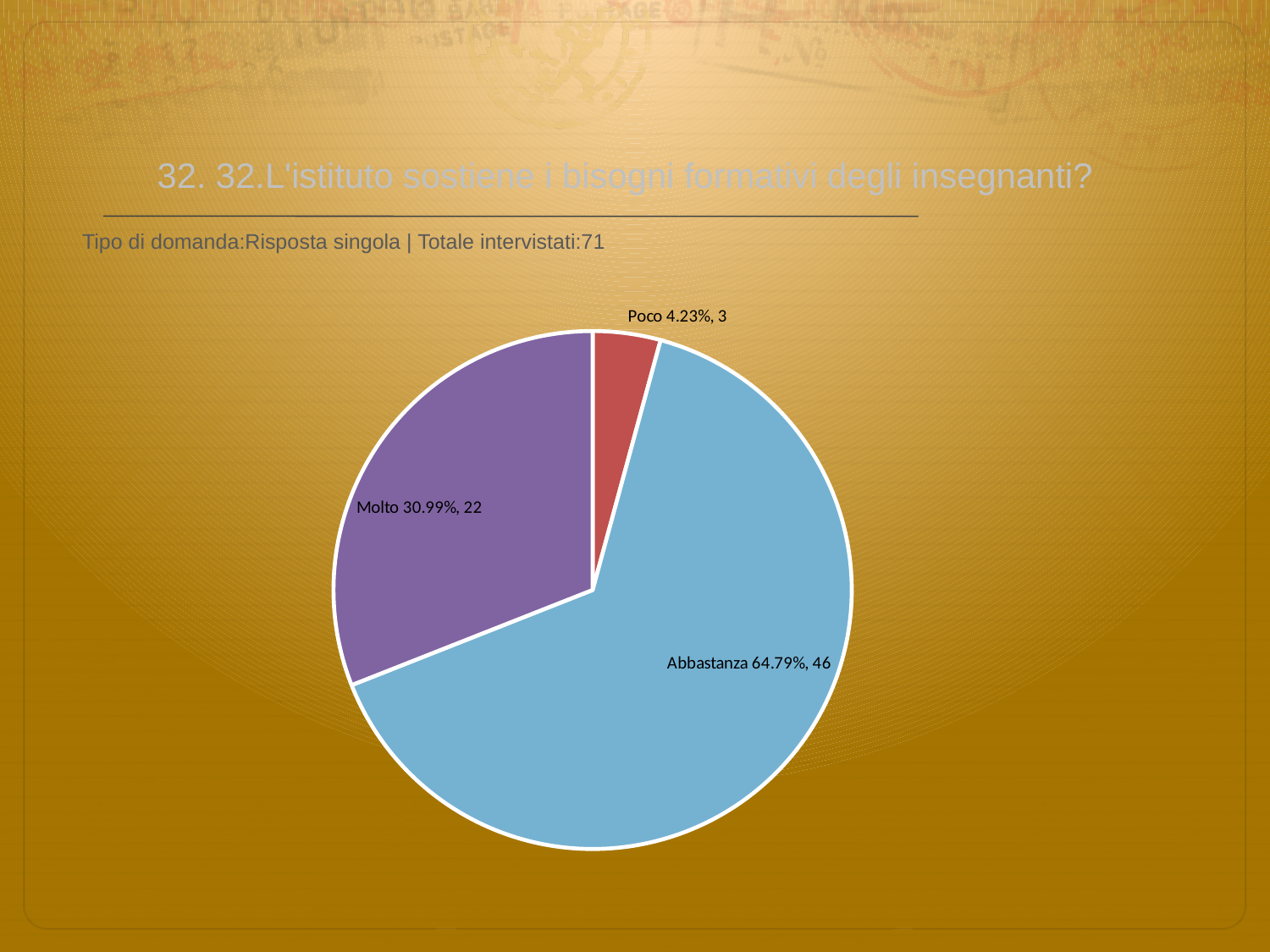
What kind of chart is shown on the slide? pie chart How many slices does the pie chart have? 3 Which has more respondents, Molto or Poco? Molto What percentage share does the Poco slice have? 4.23% What percentage share does the Abbastanza slice have? 64.79% Which category has the smallest slice? Poco How many respondents answered Poco? 3 How many respondents answered Abbastanza? 46 What is the difference in respondent count between Abbastanza and Molto? 24 What percentage share does the Molto slice have? 30.99% How many respondents answered Molto? 22 Which category has the largest slice? Abbastanza